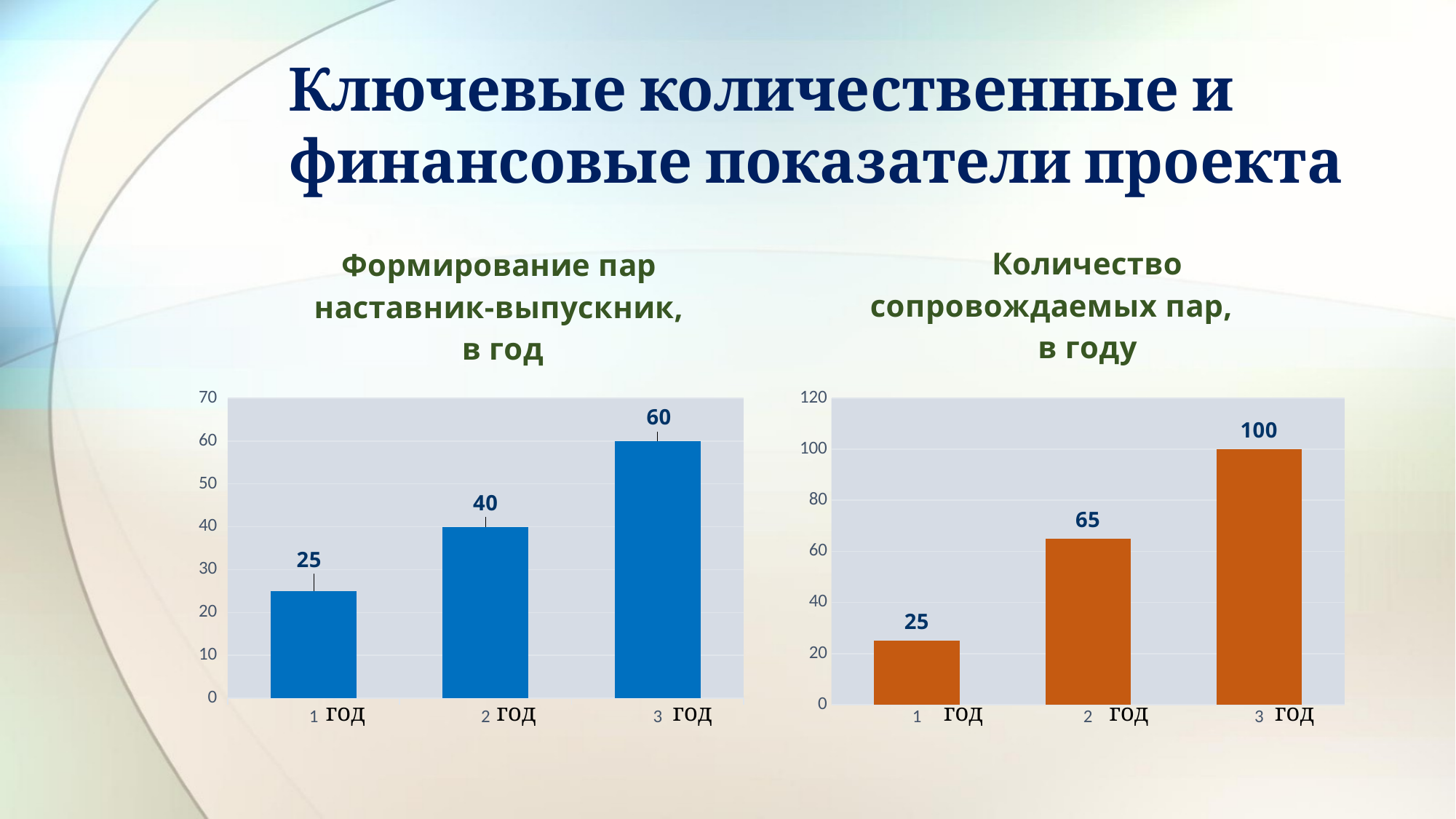
In the left chart 'Формирование пар наставник-выпускник, в год', which category has the highest value? 3 год In the right chart 'Количество сопровождаемых пар, в году', do the values rise or fall from 1 год to 3 год? rise In the right chart 'Количество сопровождаемых пар, в году', what is the difference between the values for 2 год and 1 год? 40 In the left chart 'Формирование пар наставник-выпускник, в год', what is the difference between the values for 3 год and 1 год? 35 What kind of chart is the left chart 'Формирование пар наставник-выпускник, в год'? bar chart In the right chart 'Количество сопровождаемых пар, в году', which is larger: the value for 2 год or 3 год? 3 год In the right chart 'Количество сопровождаемых пар, в году', which category has the lowest value? 1 год In the left chart 'Формирование пар наставник-выпускник, в год', what is the value for 2 год? 40 In the right chart 'Количество сопровождаемых пар, в году', what is the value for 3 год? 100 How many categories does the right chart 'Количество сопровождаемых пар, в году' show? 3 In the left chart 'Формирование пар наставник-выпускник, в год', is the value for 3 год greater or less than 50? greater What colour are the bars in the right chart 'Количество сопровождаемых пар, в году'? orange